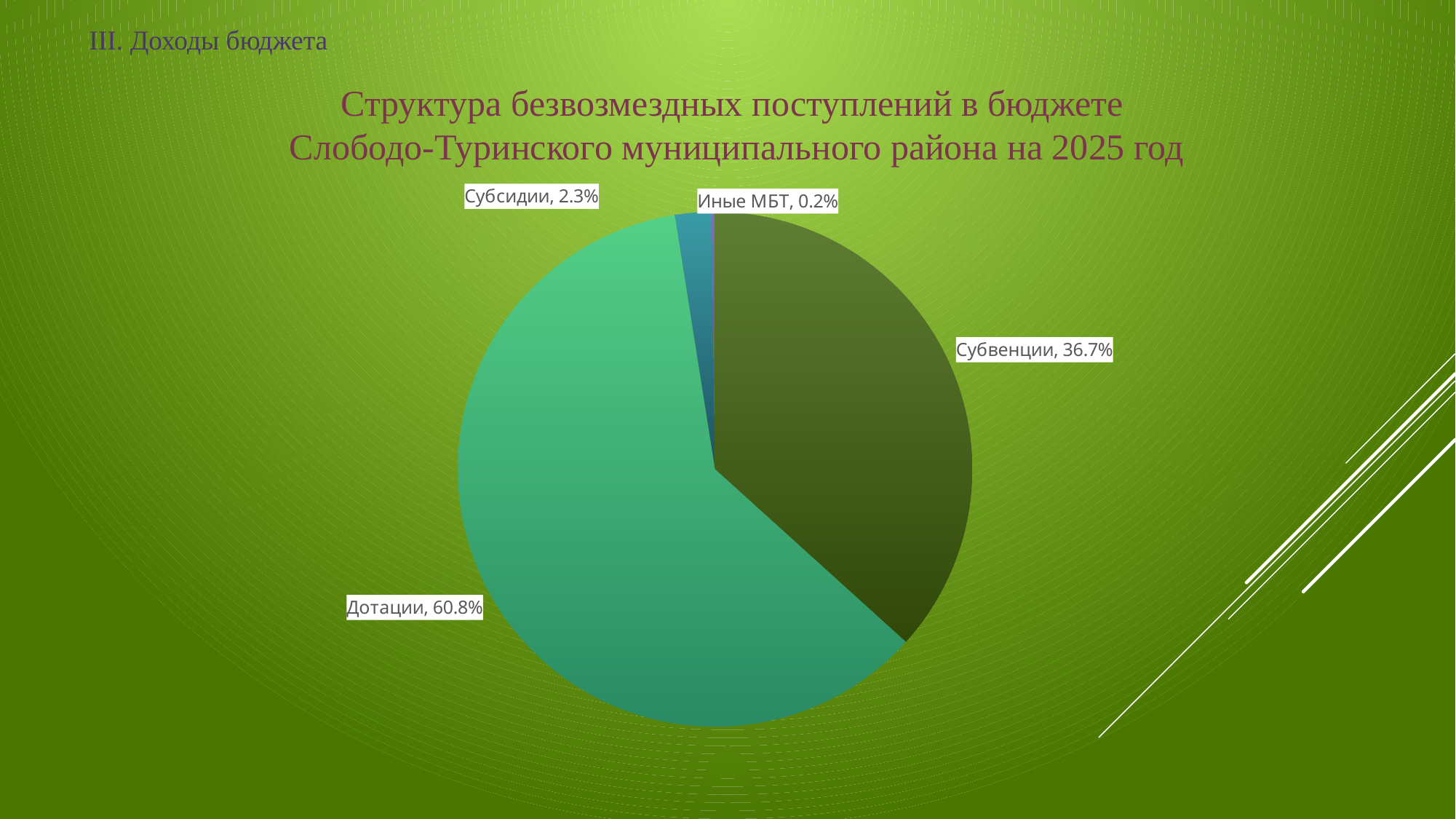
What share of the pie does Дотации account for? 60.8% What kind of chart is shown on the slide? Pie chart What is the value shown for Субсидии? 2.3% What is the value shown for Иные МБТ? 0.2% What is the value shown for Субвенции? 36.7% Which category has the largest slice of the pie? Дотации Which category has the smallest slice of the pie? Иные МБТ What is the combined share of Субсидии and Иные МБТ? 2.5% Which is larger, the share of Субсидии or the share of Иные МБТ? Субсидии What is the difference between the shares of Дотации and Субвенции? 24.1% How many categories are shown in the pie chart? 4 What year does the chart title refer to? 2025